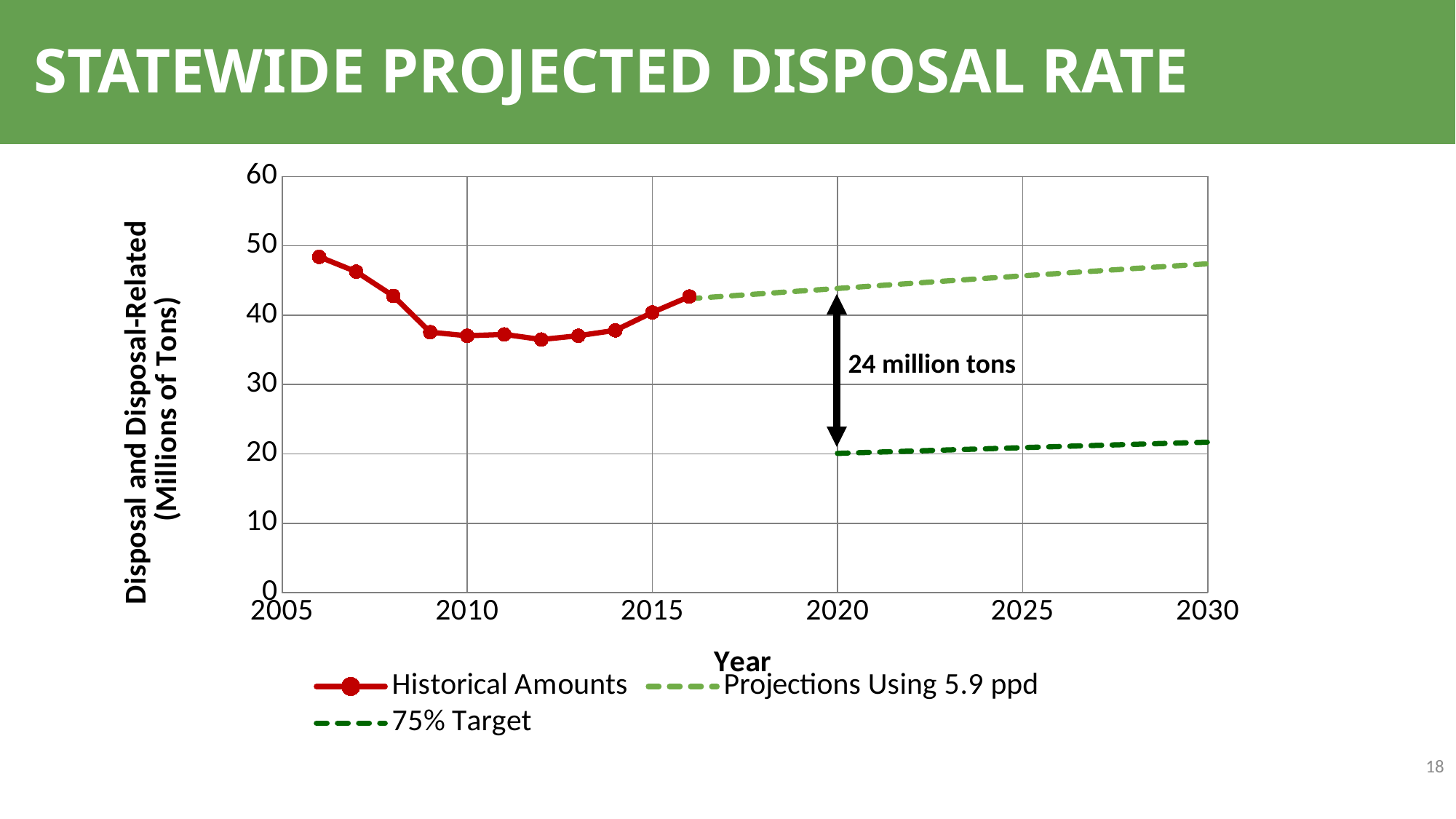
Is the 75% Target value for 2030 greater or less than 30? less Is the Historical Amounts value for 2012 greater or less than 40? less How many series does the legend list? 3 According to the annotation on the chart, what is the gap between the projection using 5.9 ppd and the 75% target in 2020? 24 million tons In which year is the Historical Amounts value highest? 2006 Is the Historical Amounts value for 2006 greater or less than 40? greater How many data points are plotted for the Historical Amounts series? 11 Do the Projections Using 5.9 ppd values rise or fall from 2016 to 2030? rise What is the label on the y axis of the chart? Disposal and Disposal-Related (Millions of Tons) What kind of chart is shown on the slide? line chart Which is larger, the Historical Amounts value for 2016 or for 2010? 2016 What is the title of the chart? STATEWIDE PROJECTED DISPOSAL RATE